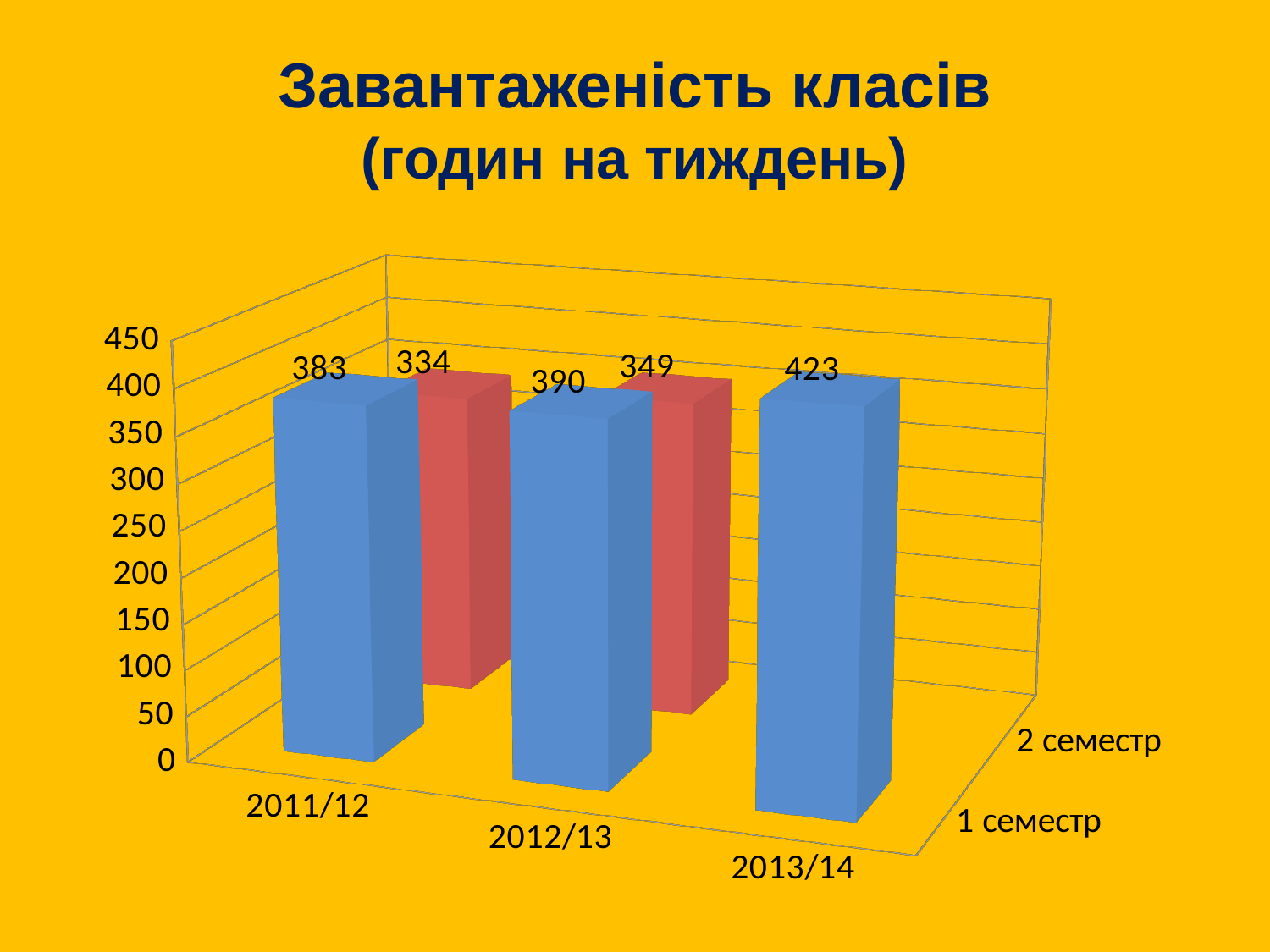
What is the value for 1 семестр in 2013/14? 423 What is the value for 2 семестр in 2012/13? 349 How many years are shown on the x axis? 3 What is the value for 1 семестр in 2011/12? 383 Which bar has the lowest value on the chart? 2 семестр in 2011/12 Which is larger: the 1 семестр value in 2011/12 or the 1 семестр value in 2012/13? 2012/13 What is the title of the chart? Завантаженість класів (годин на тиждень) What is the value for 2 семестр in 2011/12? 334 Do the 1 семестр values rise or fall from 2011/12 to 2013/14? rise What is the difference between the 1 семестр and 2 семестр values in 2012/13? 41 What kind of chart is shown on the slide? bar chart Which year has the highest value for 1 семестр? 2013/14